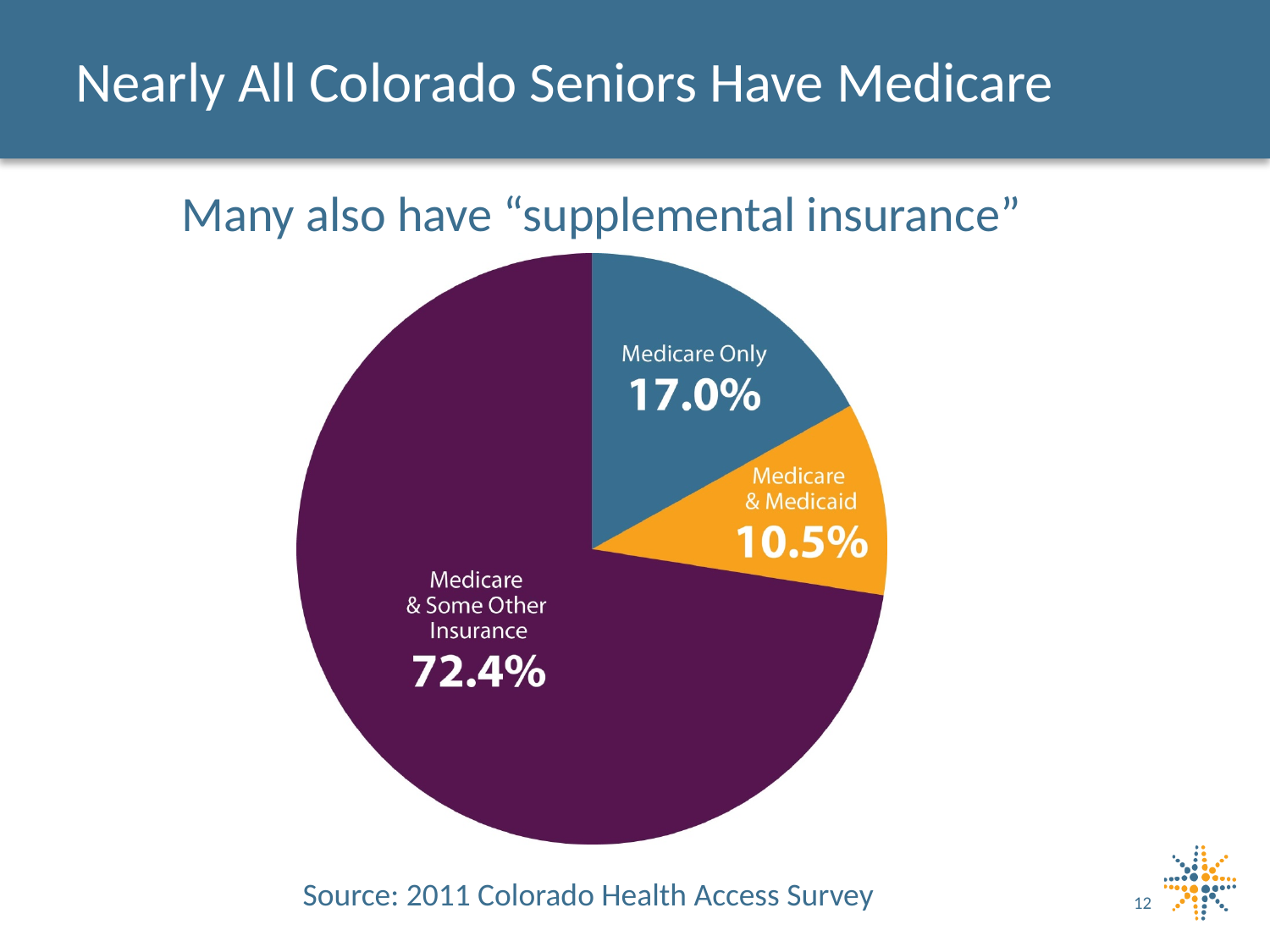
Which category has the largest slice of the pie? Medicare & Some Other Insurance What is the source cited below the chart? 2011 Colorado Health Access Survey Which category has the smallest slice of the pie? Medicare & Medicaid What is the difference in percentage points between Medicare & Some Other Insurance and Medicare Only? 55.4 How many slices does the pie chart have? 3 What type of chart is shown on the slide? Pie chart What share of Colorado seniors have Medicare Only? 17.0% What is the difference in percentage points between Medicare Only and Medicare & Medicaid? 6.5 What colour is the Medicare & Medicaid slice? Orange What share of Colorado seniors have Medicare & Medicaid? 10.5% What share of Colorado seniors have Medicare & Some Other Insurance? 72.4% Which is larger: the Medicare Only slice or the Medicare & Medicaid slice? Medicare Only